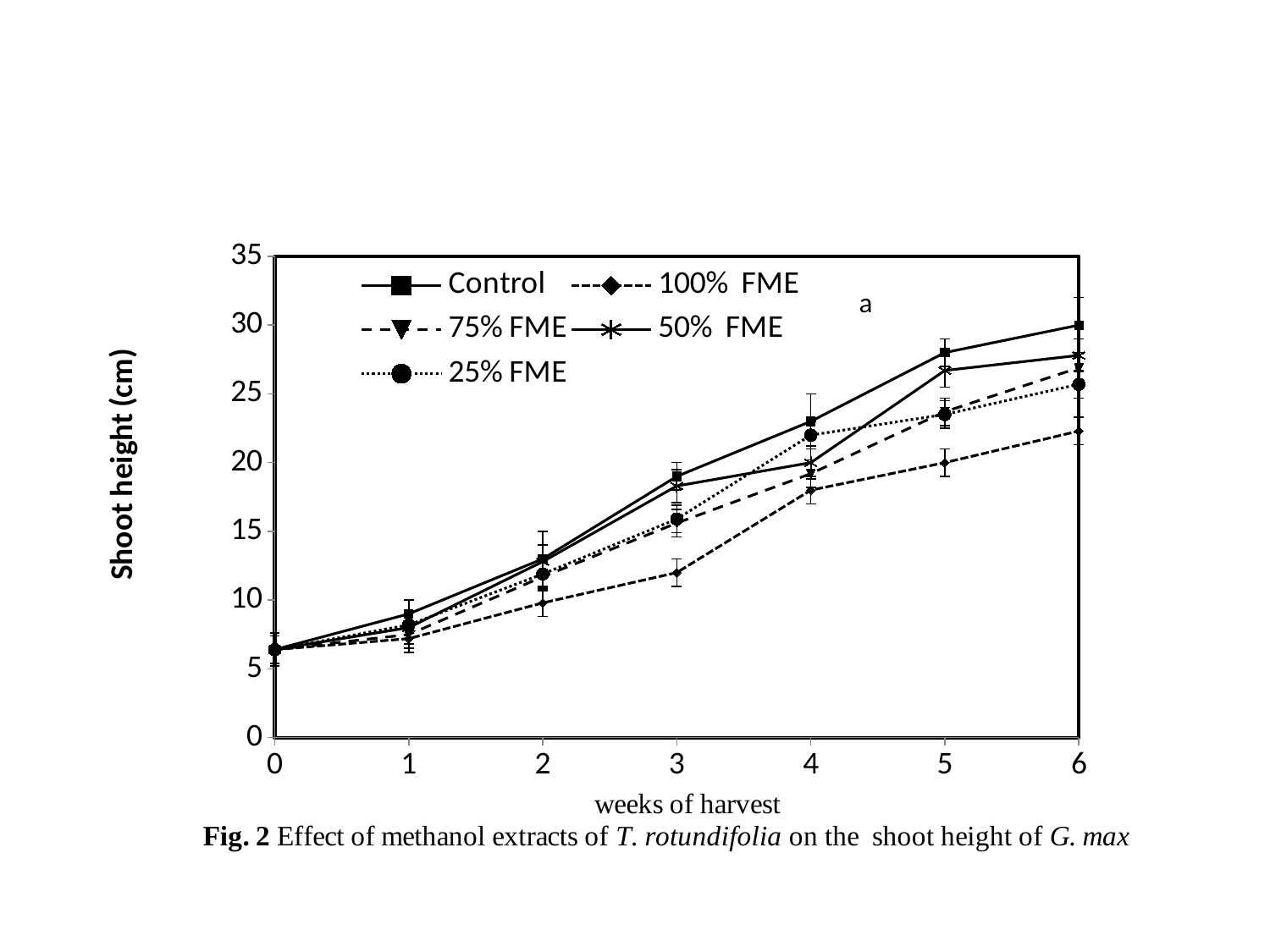
How many series does the legend list? 5 Is the shoot height for Control at week 5 greater or less than 25? greater Is the shoot height for 100% FME at week 6 greater or less than 25? less Which series has the highest shoot height at week 6? Control How many weeks of harvest are plotted along the x axis for each series? 7 Is the shoot height for Control at week 6 greater or less than 25? greater Does the shoot height for Control rise or fall from week 0 to week 6? rise At week 4, which is larger: the shoot height for Control or for 100% FME? Control What is the label of the y axis? Shoot height (cm) Which series has the lowest shoot height at week 6? 100% FME What kind of chart is shown on the slide? line chart